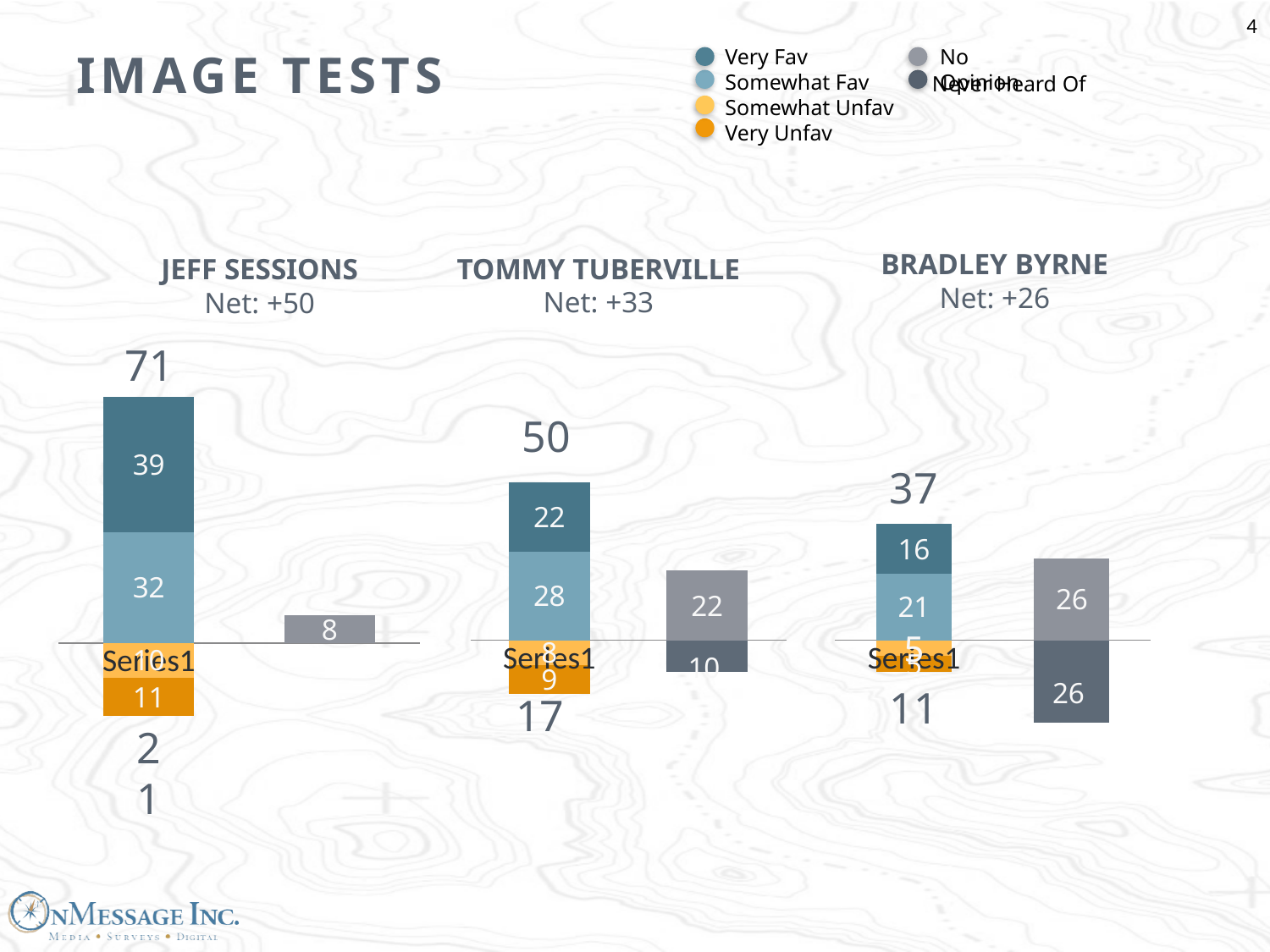
On the Tommy Tuberville chart, what is the No Opinion value? 22 On the Bradley Byrne chart, what is the Never Heard Of value? 26 On the Jeff Sessions chart, what is the Somewhat Fav value? 32 Which of the three candidates has the highest total favorable? Jeff Sessions How many series does the legend list? 6 On the Jeff Sessions chart, what is the Very Fav value? 39 On the Jeff Sessions chart, what is the total favorable shown above the stacked bar? 71 On the Tommy Tuberville chart, what is the Somewhat Fav value? 28 On the Tommy Tuberville chart, what is the total favorable shown above the stacked bar? 50 On the Jeff Sessions chart, what is the No Opinion value? 8 On the Jeff Sessions chart, what is the difference between the Very Fav and Somewhat Fav values? 7 On the Bradley Byrne chart, what is the Very Fav value? 16